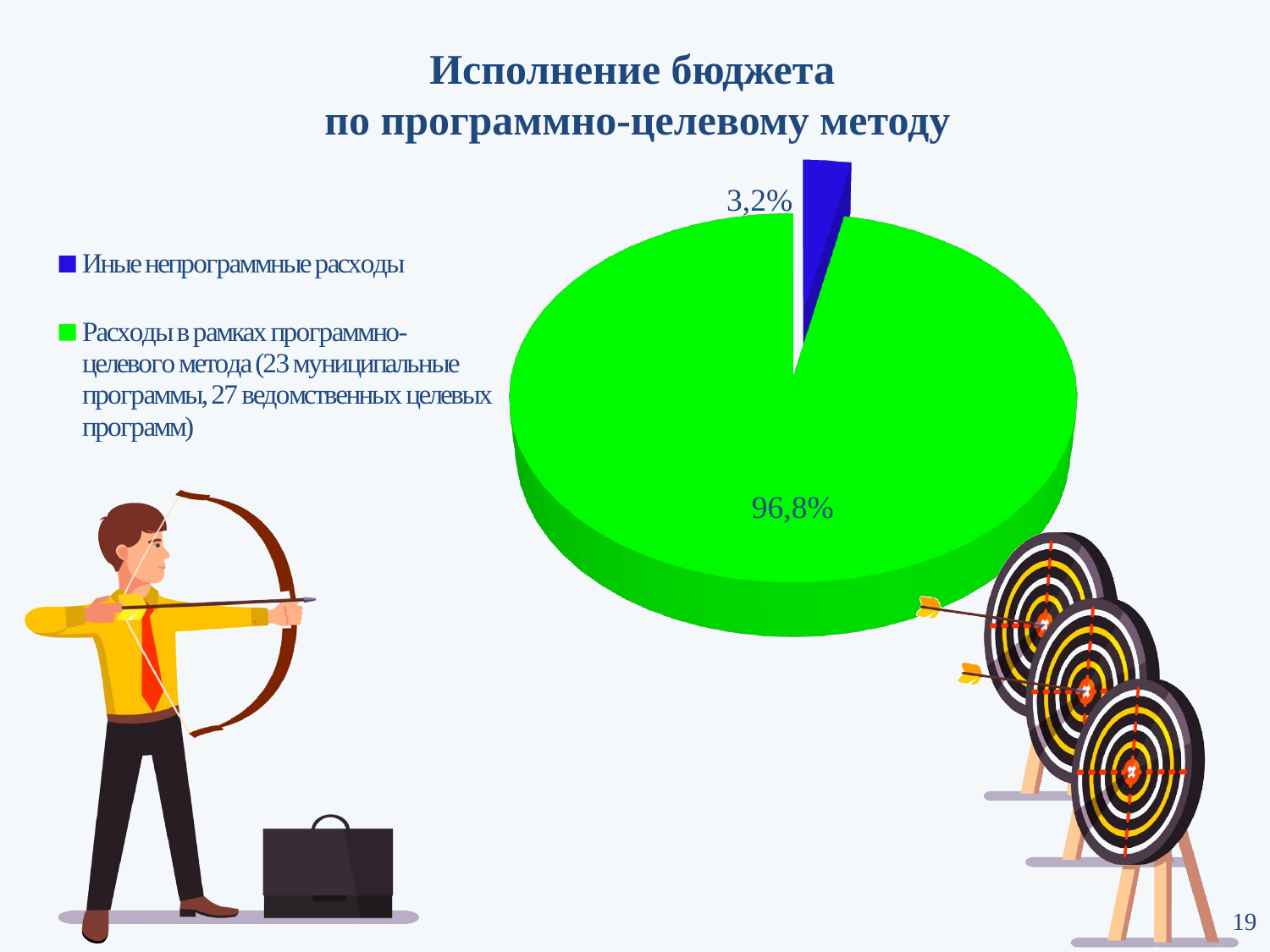
Which slice of the pie is the largest? Расходы в рамках программно-целевого метода Which slice of the pie is the smallest? Иные непрограммные расходы What is the difference in percentage points between the two slices of the pie? 93,6 What is the total of the two percentages shown on the pie chart? 100% What share of the pie does "Расходы в рамках программно-целевого метода" represent? 96,8% What is the title of the chart on the slide? Исполнение бюджета по программно-целевому методу What type of chart is shown on the slide? Pie chart What share of the pie does "Иные непрограммные расходы" represent? 3,2% How many entries does the legend list? 2 How many slices does the pie chart have? 2 What colour is the slice for "Иные непрограммные расходы"? Blue Which is larger: the share for "Иные непрограммные расходы" or the share for "Расходы в рамках программно-целевого метода"? Расходы в рамках программно-целевого метода